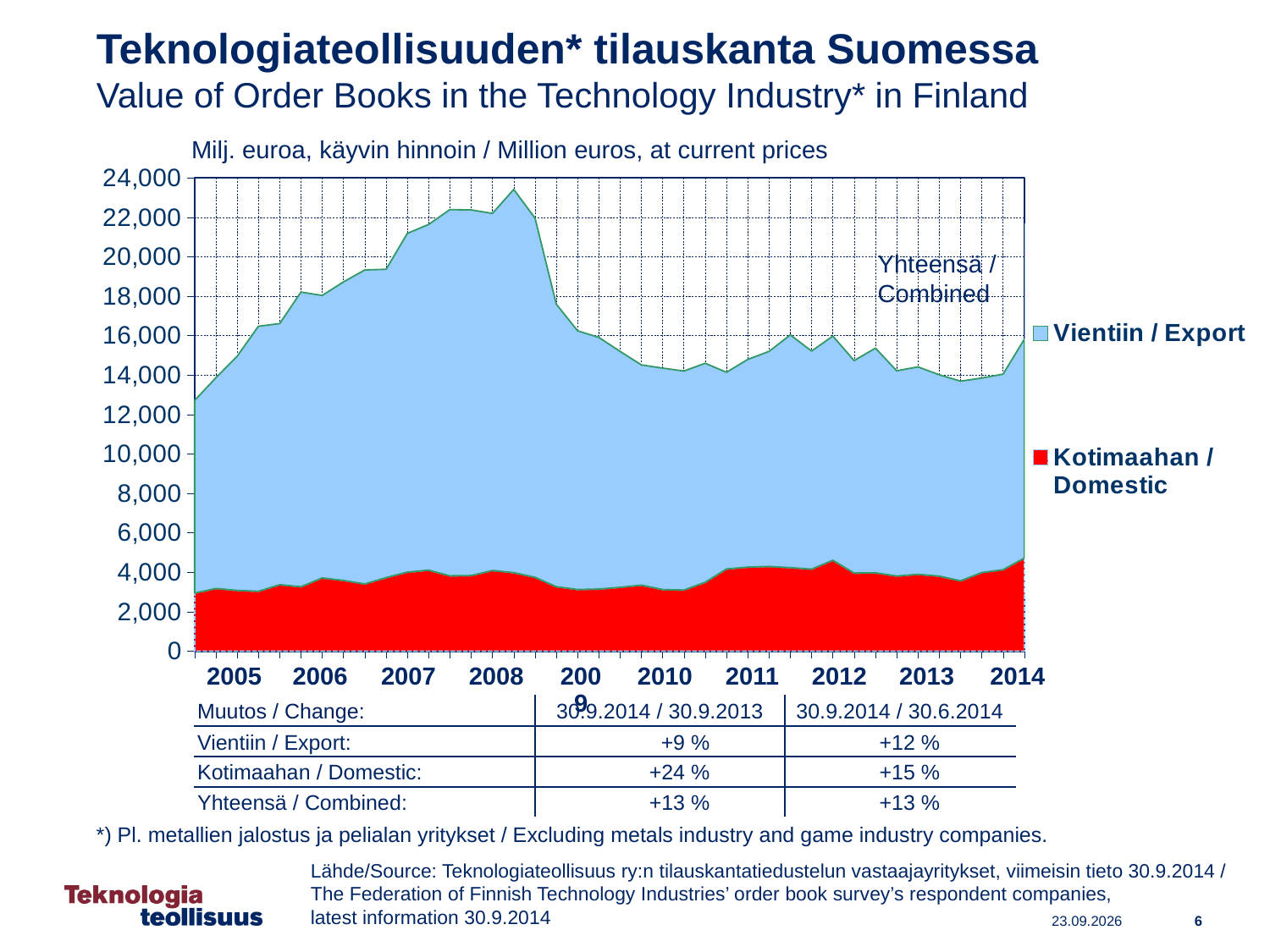
How many years are labelled on the x axis of the chart? 10 Does the combined order book value rise or fall between its 2008 peak and 2009? fall According to the table, what is the change in Kotimaahan / Domestic for 30.9.2014 / 30.6.2014? +15 % Which series is shown in red in the chart? Kotimaahan / Domestic What unit is stated for the values in the chart? Milj. euroa, käyvin hinnoin / Million euros, at current prices How many series does the chart legend list? 2 What kind of chart is shown on the slide? Stacked area chart According to the table, what is the change in Vientiin / Export for 30.9.2014 / 30.9.2013? +9 % In which year does the combined order book value reach its highest peak? 2008 Is the Kotimaahan / Domestic value at the start of 2005 greater or less than 4,000? less Is the peak combined value in 2008 greater or less than 22,000? greater